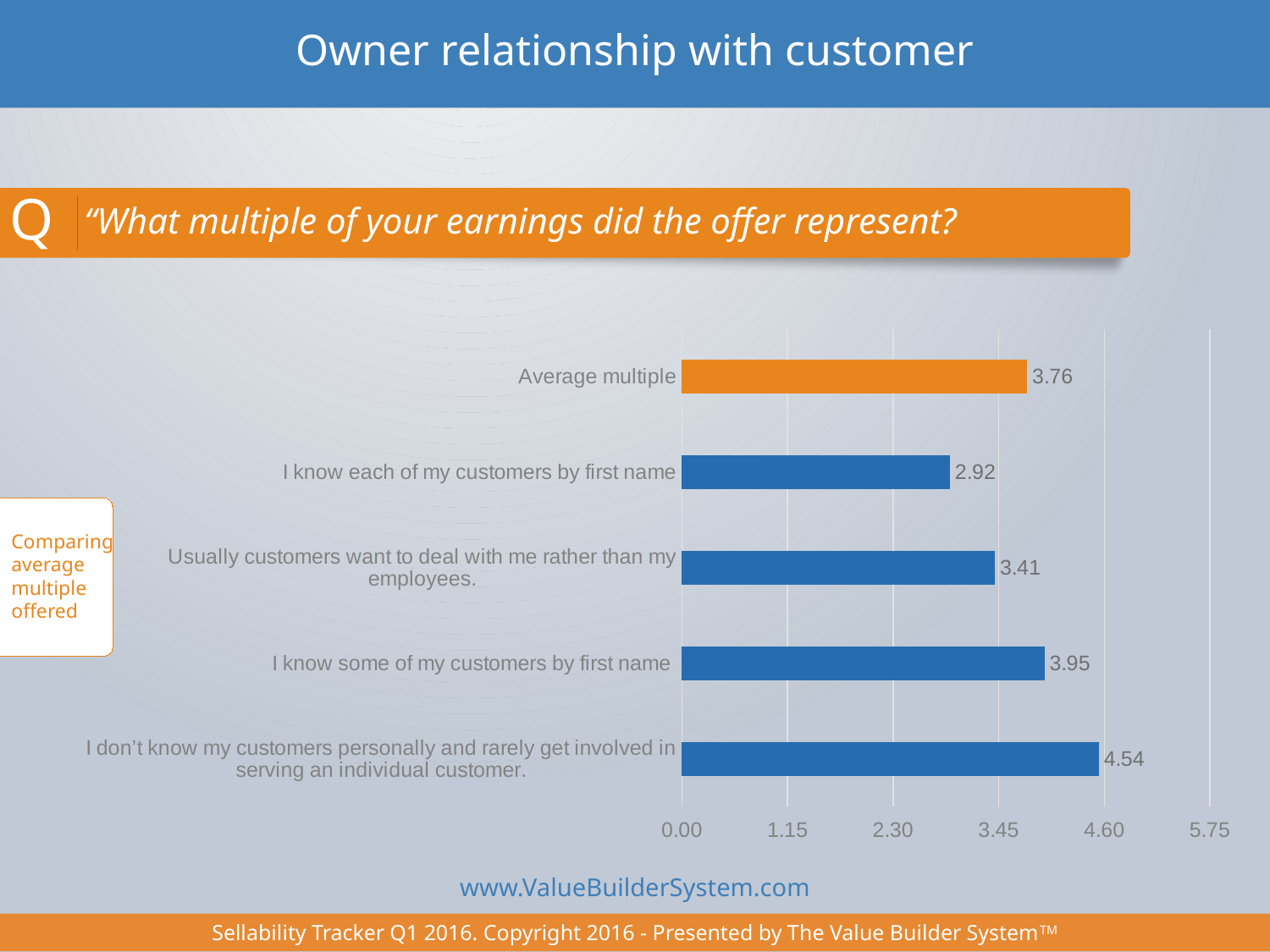
Which category has the highest value? I don't know my customers personally and rarely get involved in serving an individual customer. What kind of chart is shown on the slide? Bar chart Which bar is coloured orange rather than blue? Average multiple Which category has the lowest value? I know each of my customers by first name Which is larger: the value for "Usually customers want to deal with me rather than my employees." or the value for "I know some of my customers by first name"? I know some of my customers by first name What is the value for "I don't know my customers personally and rarely get involved in serving an individual customer."? 4.54 What is the value for "Average multiple"? 3.76 What is the difference between the value for "I don't know my customers personally and rarely get involved in serving an individual customer." and the value for "I know each of my customers by first name"? 1.62 Is the value for "Usually customers want to deal with me rather than my employees." greater or less than 3.45? less How many bars are shown in the chart? 5 What is the value for "I know some of my customers by first name"? 3.95 What is the value for "I know each of my customers by first name"? 2.92